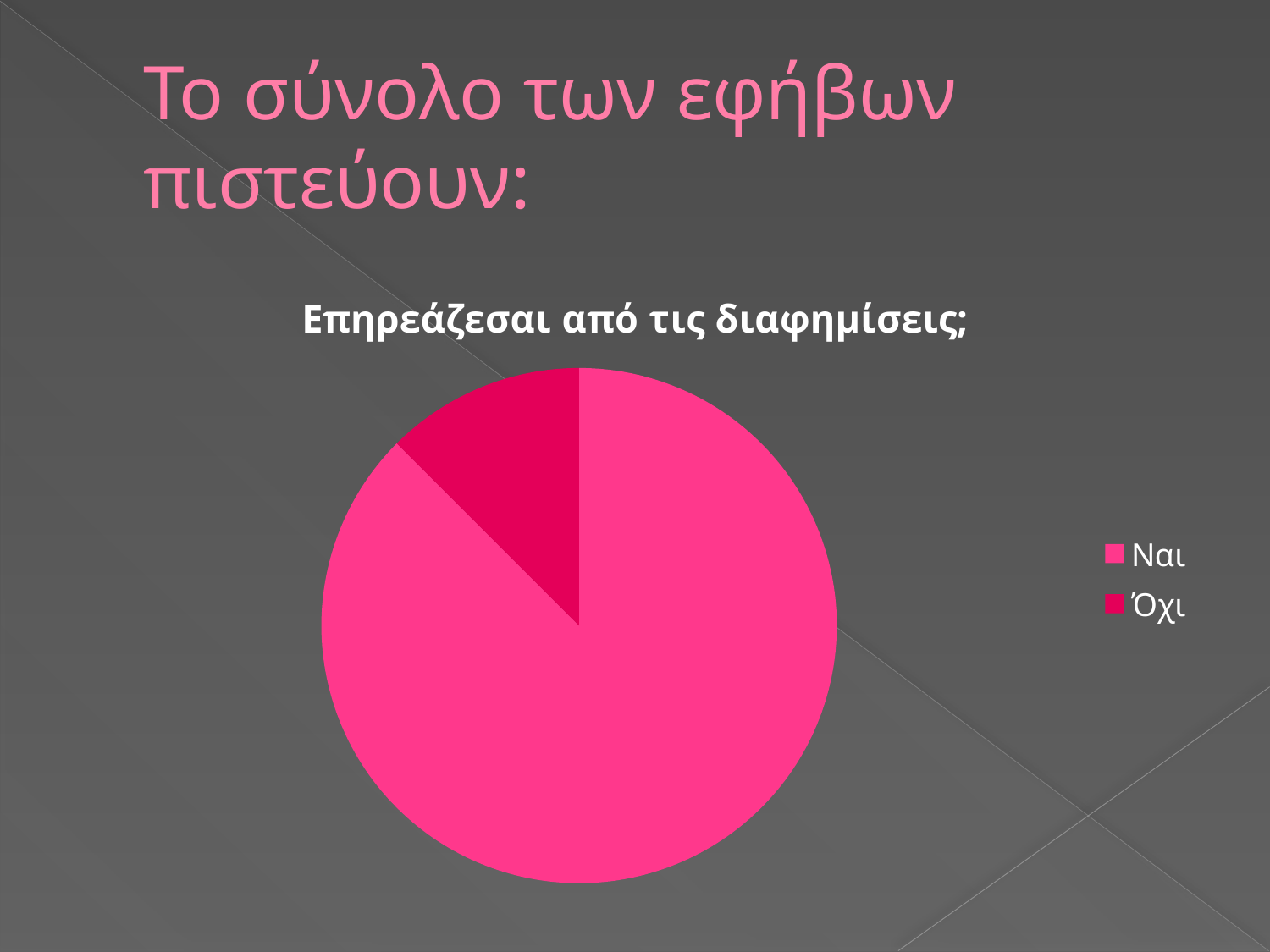
How many slices does the pie chart have? 2 What kind of chart is shown on the slide? pie chart What are the two categories shown in the legend? Ναι and Όχι Which category has the largest slice of the pie? Ναι Which category has the smallest slice of the pie? Όχι How many entries does the legend list? 2 What is the title of the chart? Επηρεάζεσαι από τις διαφημίσεις; Which slice is larger, Ναι or Όχι? Ναι